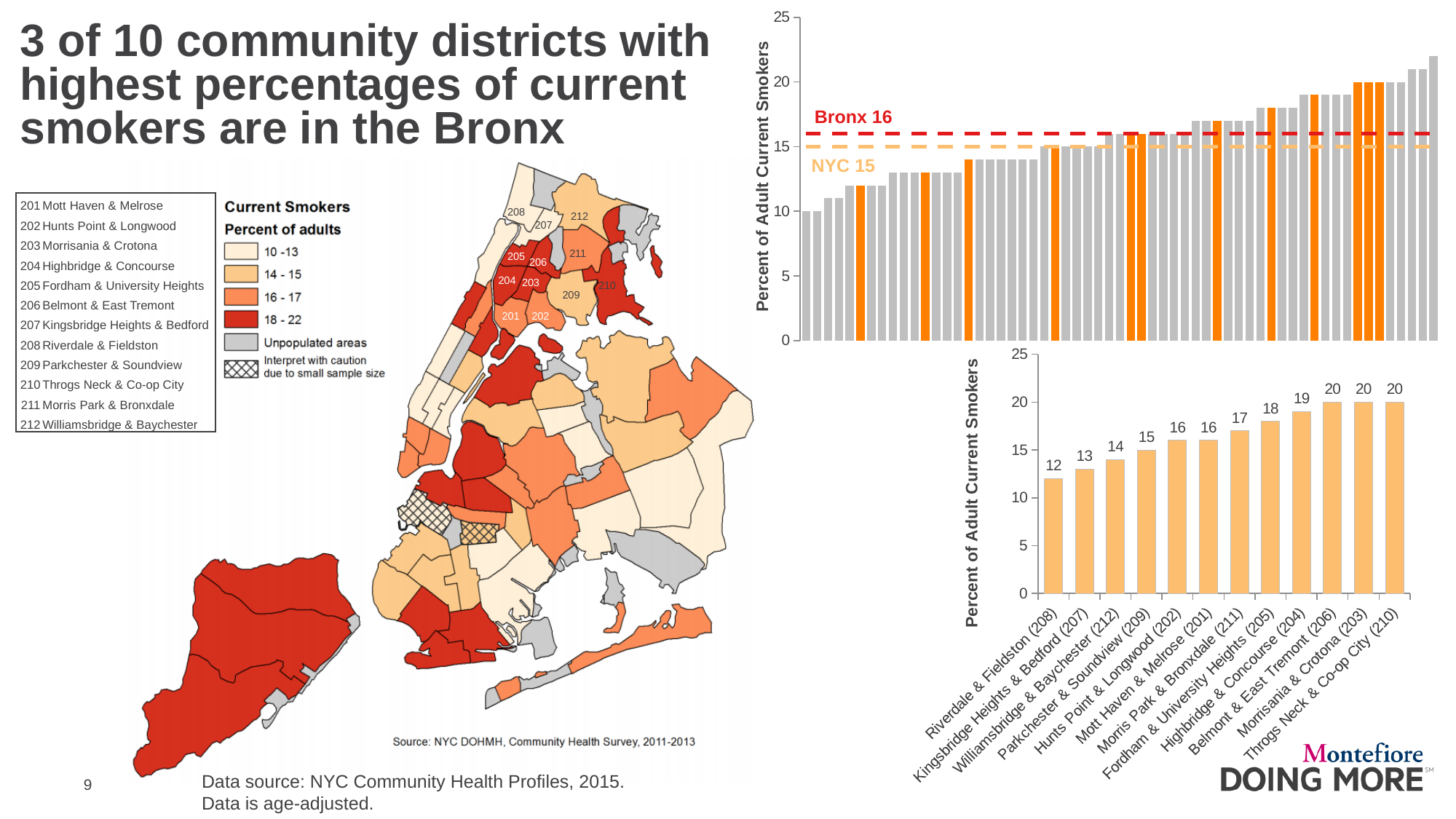
In the top chart, what value does the Bronx reference line mark? 16 What kind of chart is the bottom chart? Bar chart In the bottom chart, which is larger: the value for Fordham & University Heights (205) or Williamsbridge & Baychester (212)? Fordham & University Heights (205) In the bottom chart, do the values rise or fall from left to right along the x axis? Rise In the top chart, what value does the NYC reference line mark? 15 In the bottom chart, what is the value for Morris Park & Bronxdale (211)? 17 In the top chart, is the value of the tallest (rightmost) bar greater or less than 20? greater In the bottom chart, which community district has the lowest percent of adult current smokers? Riverdale & Fieldston (208) How many community districts are shown in the bottom chart? 12 In the bottom chart, what is the percent of adult current smokers for Riverdale & Fieldston (208)? 12 In the bottom chart, what is the difference between the values for Throgs Neck & Co-op City (210) and Riverdale & Fieldston (208)? 8 In the bottom chart, what is the percent of adult current smokers for Highbridge & Concourse (204)? 19